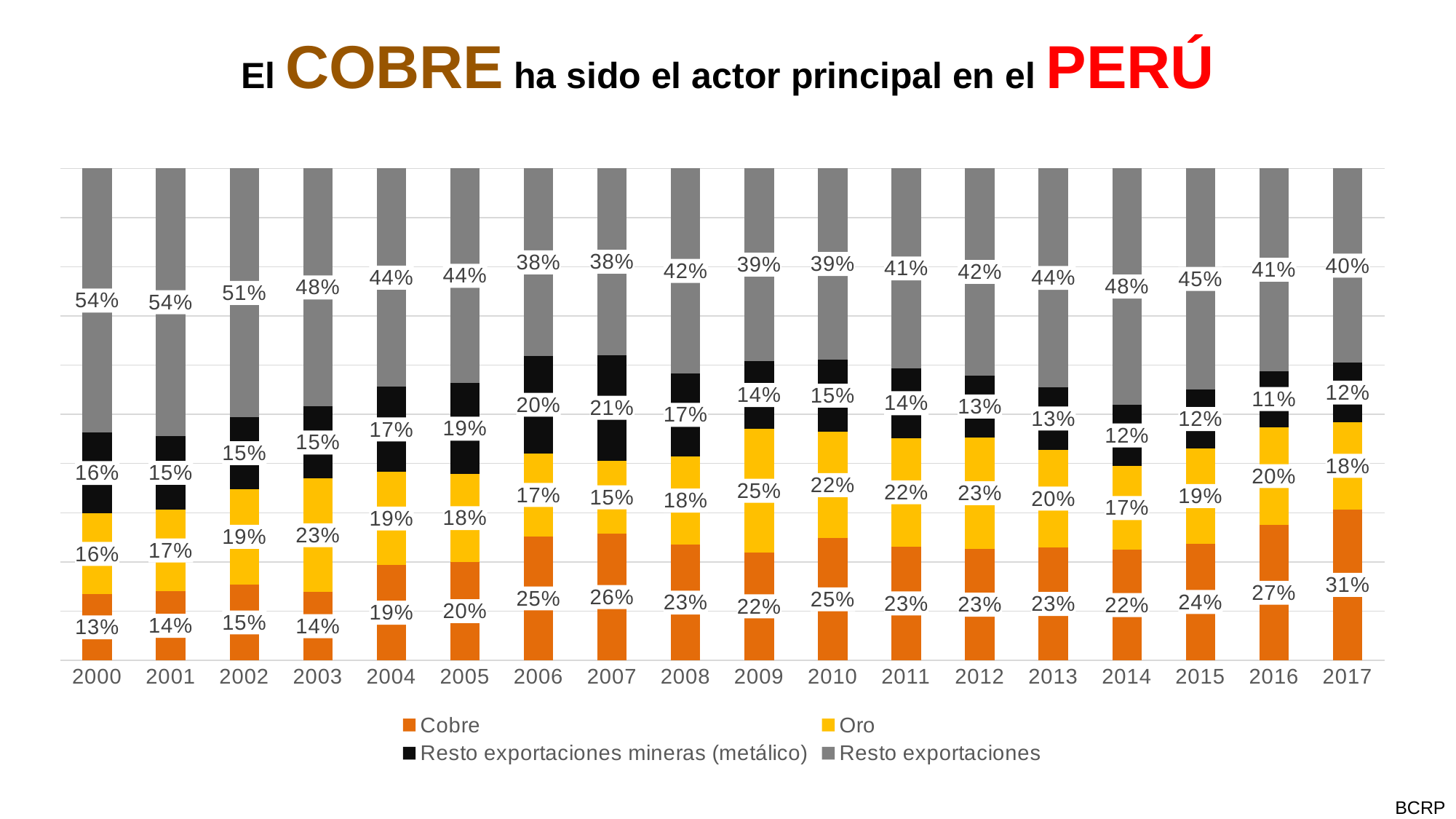
What is the difference between the Cobre value in 2017 and in 2000? 18 percentage points In which year is the Cobre share highest? 2017 What is the value for Oro in 2009? 25% What is the value for Resto exportaciones mineras (metálico) in 2007? 21% In which year is the Cobre share lowest? 2000 What is the value for Resto exportaciones in 2000? 54% How many years are shown on the x axis? 18 How many series does the legend list? 4 What kind of chart is shown on the slide? Stacked bar chart Does the Resto exportaciones share generally rise or fall from 2000 to 2017? Fall Which is larger in 2003, the Oro value or the Cobre value? Oro What is the value for Cobre in 2017? 31%